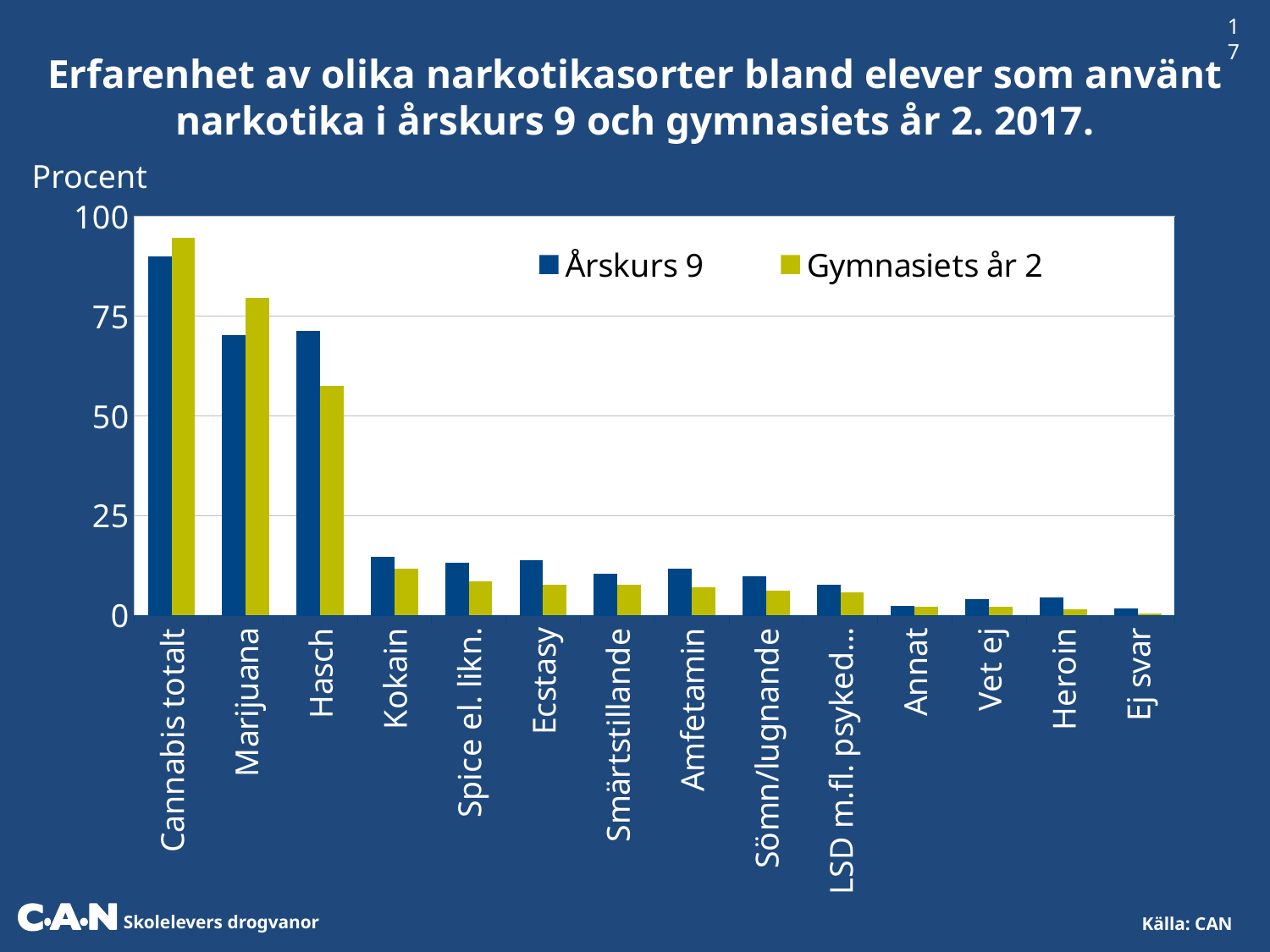
Which category has the highest value for Gymnasiets år 2? Cannabis totalt For Marijuana, which series has the larger value, Årskurs 9 or Gymnasiets år 2? Gymnasiets år 2 Is the value for Cannabis totalt in Gymnasiets år 2 greater or less than 75? greater How many categories are shown on the x axis? 14 For Hasch, which series has the larger value, Årskurs 9 or Gymnasiets år 2? Årskurs 9 Is the value for Kokain in Årskurs 9 greater or less than 25? less How many series does the legend list? 2 What kind of chart is shown on the slide? bar chart Do the values generally rise or fall from left to right along the x axis? fall What label is shown on the vertical axis? Procent Which category has the highest value for Årskurs 9? Cannabis totalt Is the value for Hasch in Årskurs 9 greater or less than 50? greater